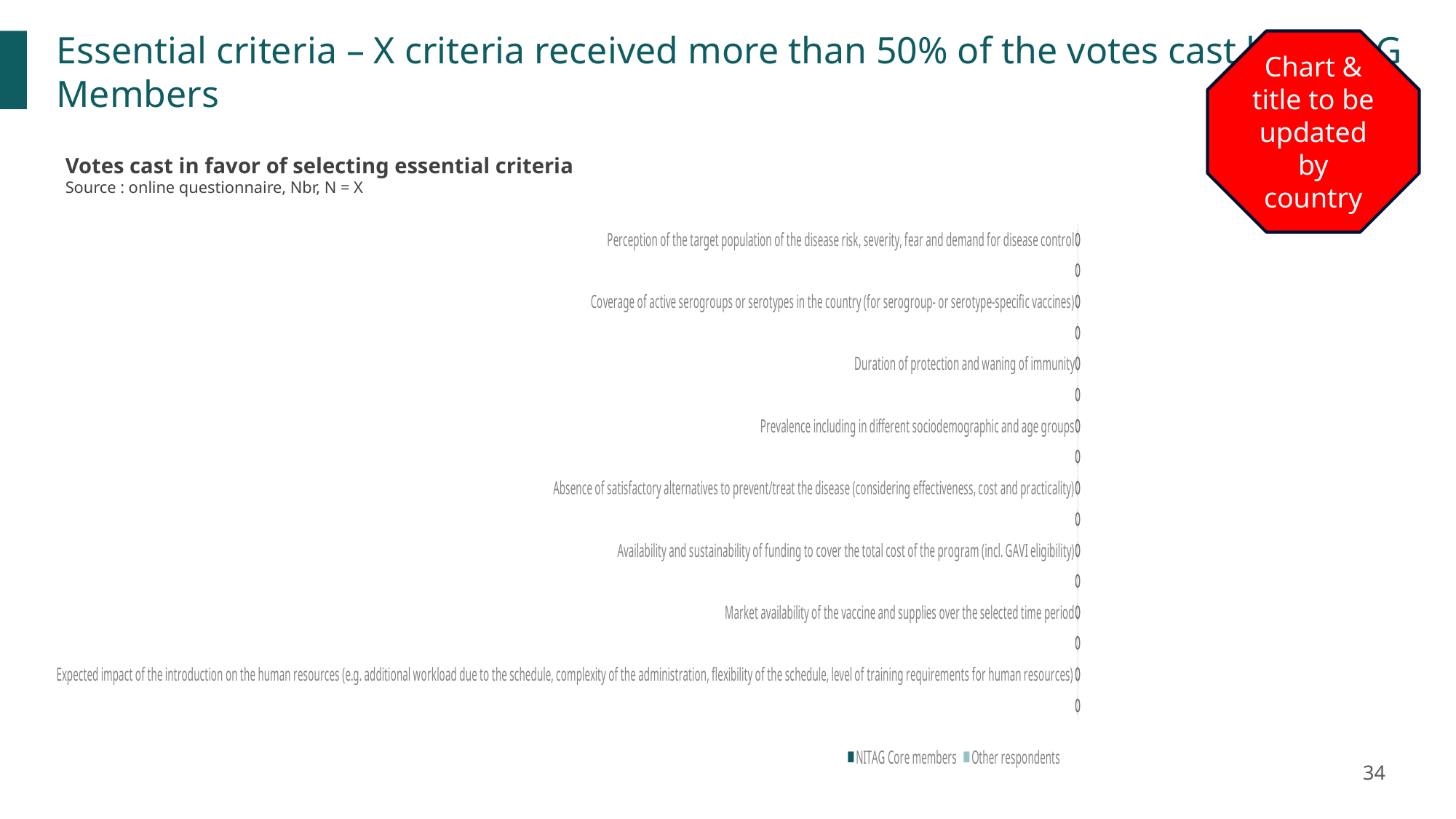
What value is shown for 'Duration of protection and waning of immunity'? 0 How many series does the chart legend list? 2 What value is shown for 'Availability and sustainability of funding to cover the total cost of the program (incl. GAVI eligibility)'? 0 How many criteria (categories) are labelled on the chart? 8 What is the title of the chart on the slide? Votes cast in favor of selecting essential criteria What value is shown for 'Prevalence including in different sociodemographic and age groups'? 0 What kind of chart is shown on the slide? bar chart What are the two series named in the chart legend? NITAG Core members and Other respondents What value is shown for 'Market availability of the vaccine and supplies over the selected time period'? 0 What value is shown for 'Coverage of active serogroups or serotypes in the country (for serogroup- or serotype-specific vaccines)'? 0 What is the difference between the values shown for 'Duration of protection and waning of immunity' and 'Market availability of the vaccine and supplies over the selected time period'? 0